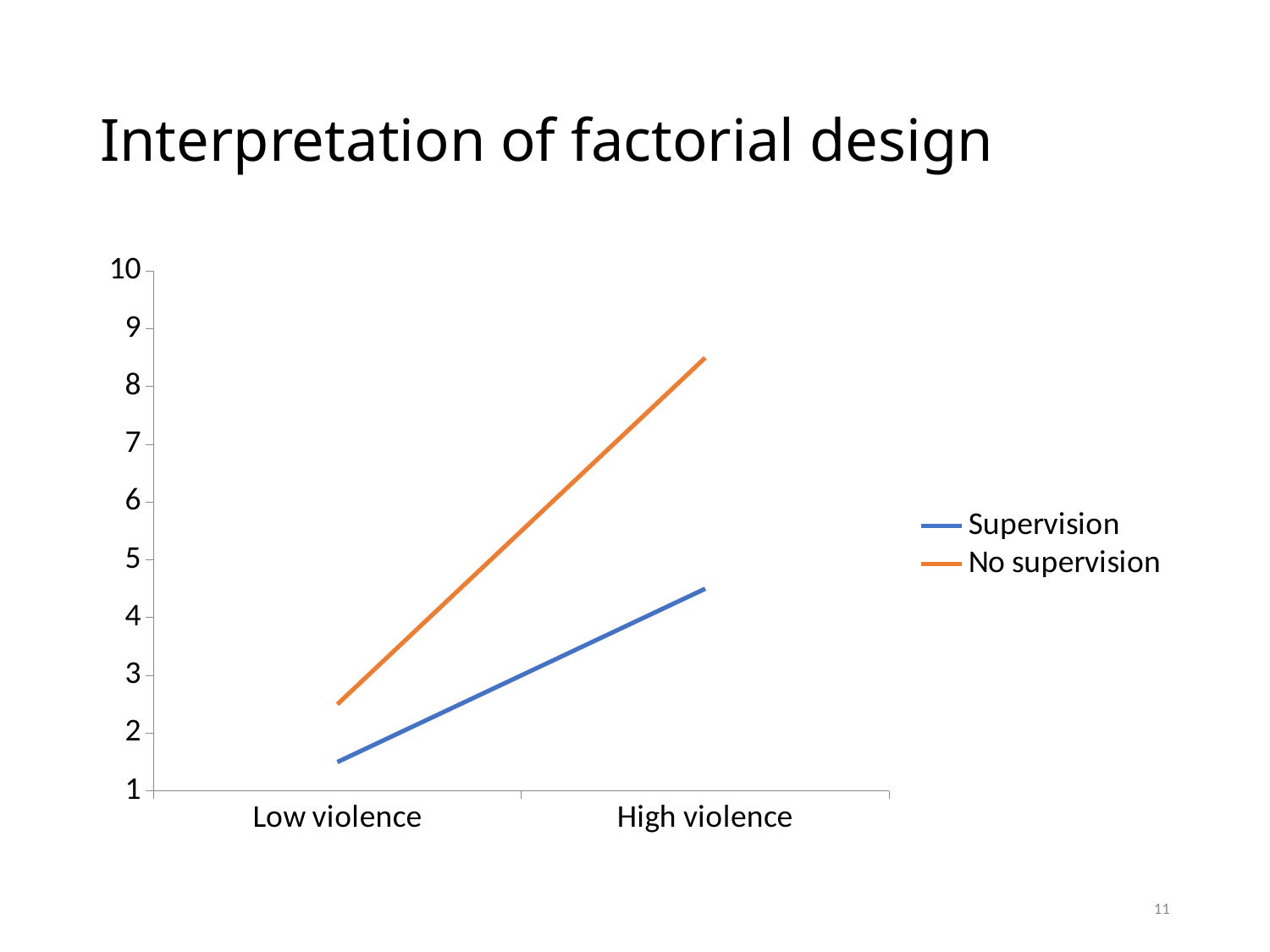
Which series is shown in orange? No supervision Is the value for No supervision at Low violence greater or less than 3? less Does the No supervision line rise or fall from Low violence to High violence? rise What is the title of the slide containing the chart? Interpretation of factorial design What kind of chart is shown on the slide? line chart Is the value for Supervision at Low violence greater or less than 2? less How many series does the legend list? 2 At High violence, which series has the higher value, Supervision or No supervision? No supervision Is the value for Supervision at High violence greater or less than 4? greater How many categories are shown on the x axis? 2